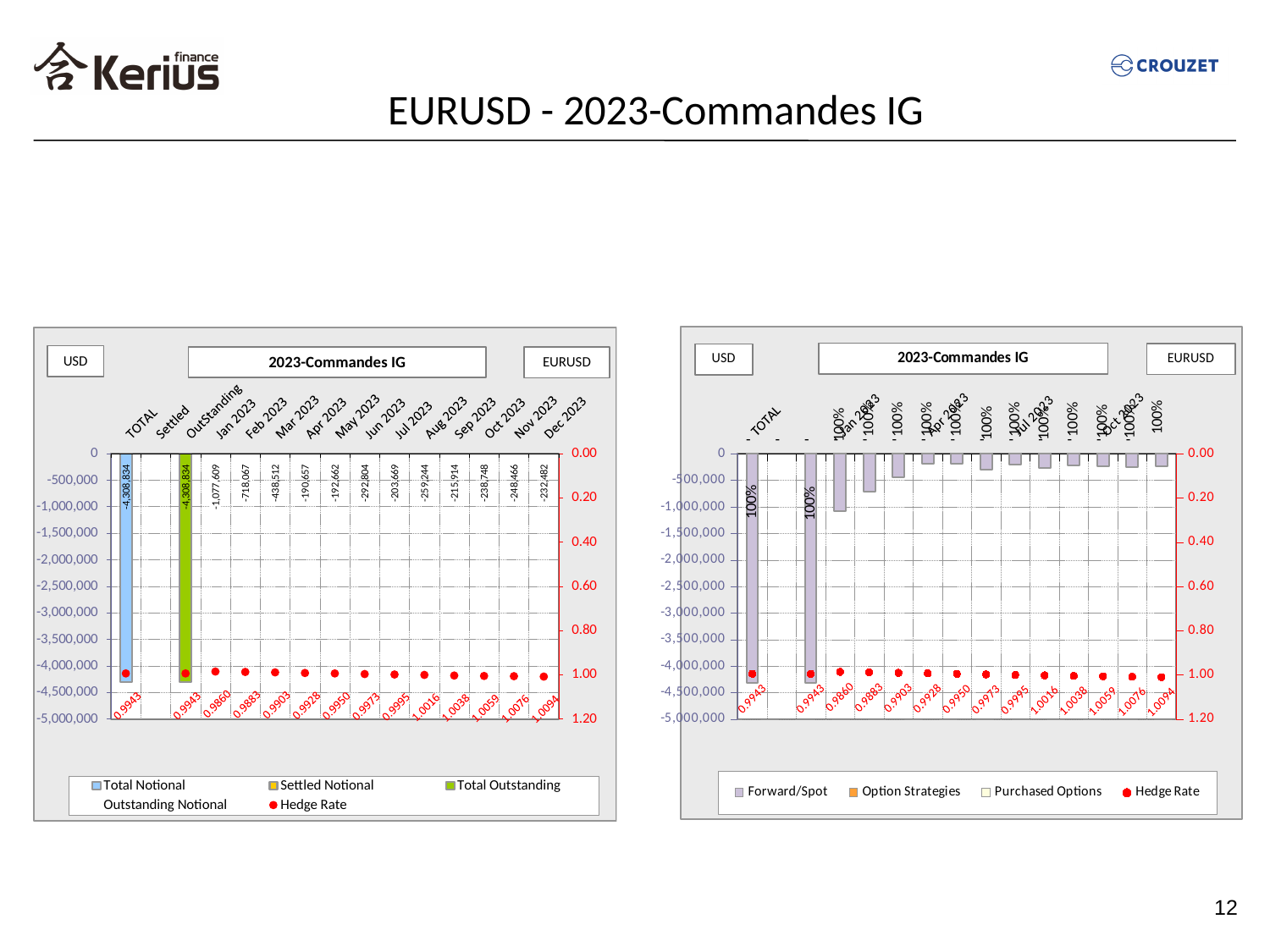
On the left chart, what is the Hedge Rate value labelled for Jan 2023? 0.9860 How many entries does the legend of the left chart list? 5 On the left chart, does the Hedge Rate for Jan 2023 to Dec 2023 rise or fall over the months? rise What is the title shown inside both charts? 2023-Commandes IG How many entries does the legend of the right chart list? 4 On the left chart, what is the value shown for Dec 2023? -232,482 On the left chart, what is the value shown for Jan 2023? -1,077,609 On the left chart, what is the Hedge Rate value labelled for Dec 2023? 1.0094 On the left chart, which month from Jan 2023 to Dec 2023 has the largest bar (most negative value)? Jan 2023 On the left chart, what is the data label on the Total Notional bar? -4,308,834 On the left chart, which has the larger magnitude, the Mar 2023 bar or the Apr 2023 bar? Mar 2023 On the left chart, what is the difference between the Jan 2023 value and the Feb 2023 value? 359,542